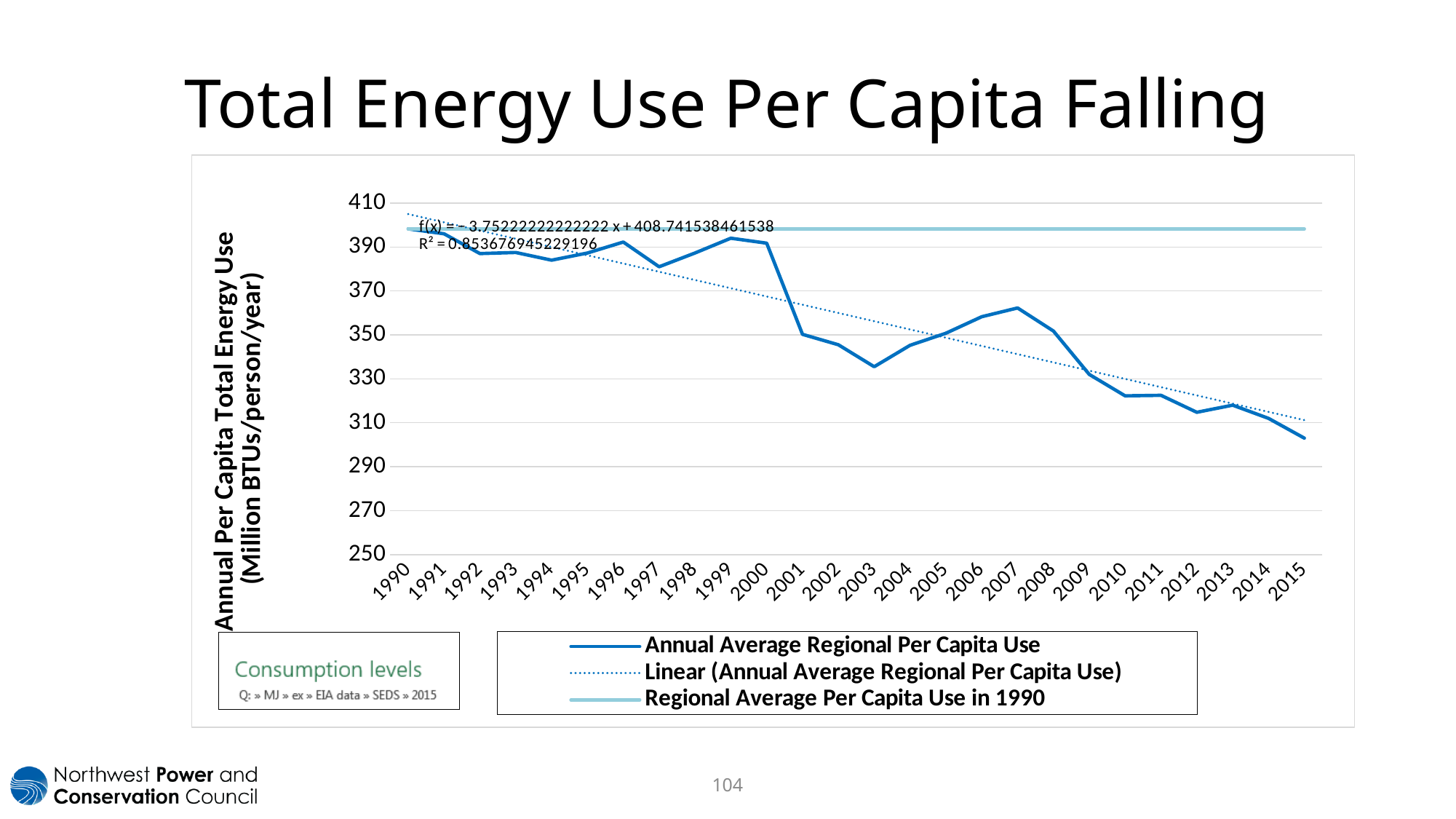
How many years are plotted along the x axis? 26 Which year has the lowest Annual Average Regional Per Capita Use? 2015 Which is larger, the Annual Average Regional Per Capita Use in 1996 or in 2001? 1996 Is the Annual Average Regional Per Capita Use for 1999 greater or less than 370? greater Is the Annual Average Regional Per Capita Use for 2007 greater or less than 350? greater What is the title of the y axis? Annual Per Capita Total Energy Use (Million BTUs/person/year) Which is larger, the Annual Average Regional Per Capita Use in 2007 or in 2003? 2007 How many series does the legend list? 3 What kind of chart is shown on the slide? line chart Does the Annual Average Regional Per Capita Use generally rise or fall from 1990 to 2015? fall Is the Annual Average Regional Per Capita Use for 2010 greater or less than 330? less